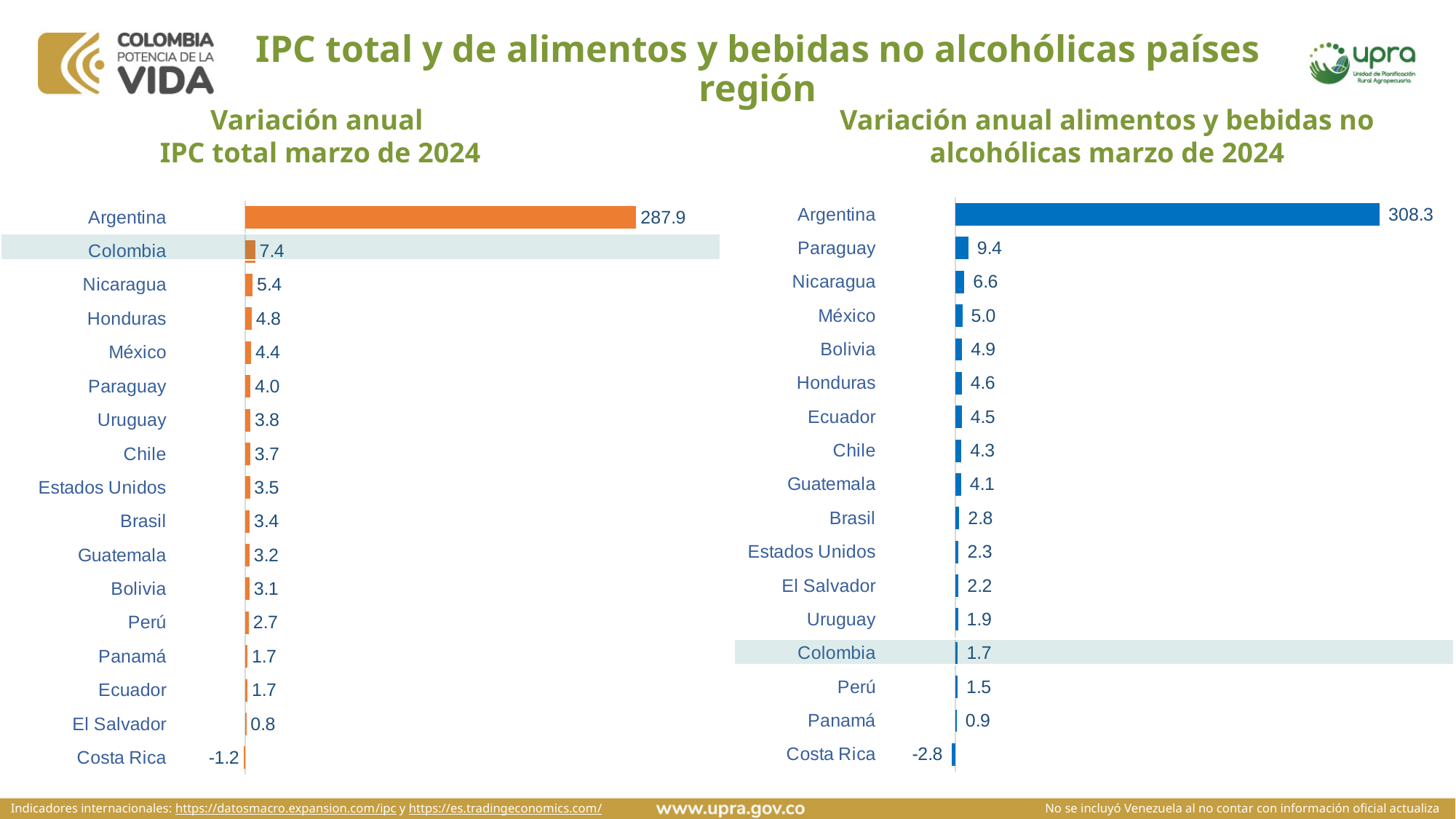
In the 'Variación anual alimentos y bebidas no alcohólicas marzo de 2024' chart, what is the value for Argentina? 308.3 In the 'Variación anual alimentos y bebidas no alcohólicas marzo de 2024' chart, what is the value for Paraguay? 9.4 In the 'Variación anual alimentos y bebidas no alcohólicas marzo de 2024' chart, which country has the lowest value? Costa Rica How many countries are shown in the 'Variación anual IPC total marzo de 2024' chart? 17 In the 'Variación anual alimentos y bebidas no alcohólicas marzo de 2024' chart, what is the difference between the values for Nicaragua and México? 1.6 In the 'Variación anual IPC total marzo de 2024' chart, what is the value for Colombia? 7.4 In the 'Variación anual alimentos y bebidas no alcohólicas marzo de 2024' chart, which is larger, the value for Colombia or the value for Uruguay? Uruguay In the 'Variación anual IPC total marzo de 2024' chart, which is larger, the value for Nicaragua or the value for Honduras? Nicaragua In the 'Variación anual IPC total marzo de 2024' chart, which country has the highest value? Argentina In the 'Variación anual IPC total marzo de 2024' chart, what is the value for Costa Rica? -1.2 What kind of chart is the 'Variación anual alimentos y bebidas no alcohólicas marzo de 2024' chart? Bar chart In the 'Variación anual IPC total marzo de 2024' chart, what is the difference between the values for Argentina and Colombia? 280.5